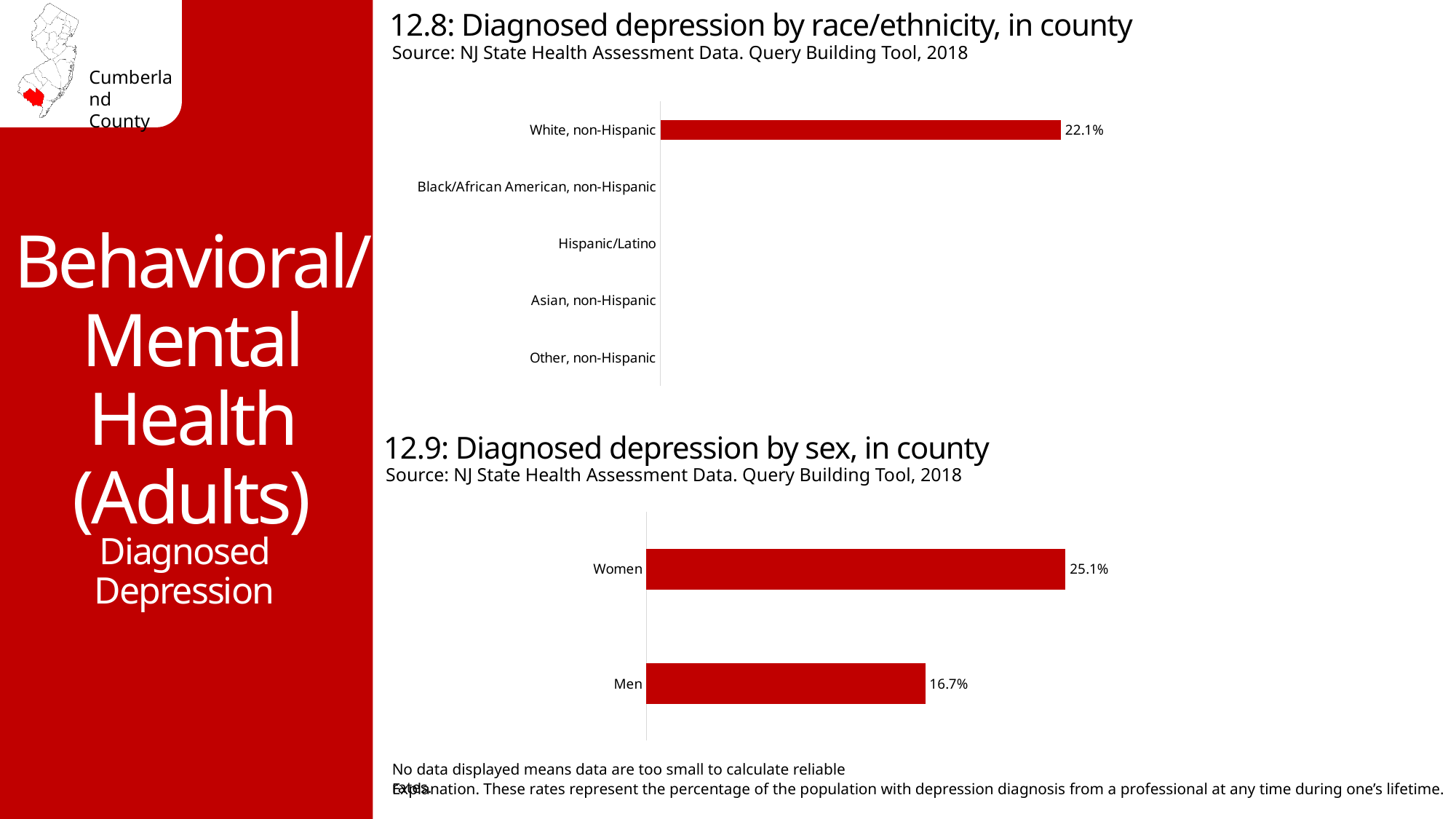
What kind of chart is '12.9: Diagnosed depression by sex, in county'? Bar chart In the chart '12.9: Diagnosed depression by sex, in county', which category has the highest value? Women In the chart '12.8: Diagnosed depression by race/ethnicity, in county', which category is the only one with a bar displayed? White, non-Hispanic In the chart '12.9: Diagnosed depression by sex, in county', what is the value for Women? 25.1% In the chart '12.9: Diagnosed depression by sex, in county', which is larger, the value for Women or the value for Men? Women How many race/ethnicity categories are listed on the axis of the chart '12.8: Diagnosed depression by race/ethnicity, in county'? 5 In the chart '12.9: Diagnosed depression by sex, in county', what is the value for Men? 16.7% In the chart '12.9: Diagnosed depression by sex, in county', what is the difference between the values for Women and Men? 8.4% In the chart '12.8: Diagnosed depression by race/ethnicity, in county', what is the value for White, non-Hispanic? 22.1% How many categories are shown in the chart '12.9: Diagnosed depression by sex, in county'? 2 In the chart '12.9: Diagnosed depression by sex, in county', which category has the lowest value? Men What is the source cited under the chart '12.8: Diagnosed depression by race/ethnicity, in county'? NJ State Health Assessment Data. Query Building Tool, 2018